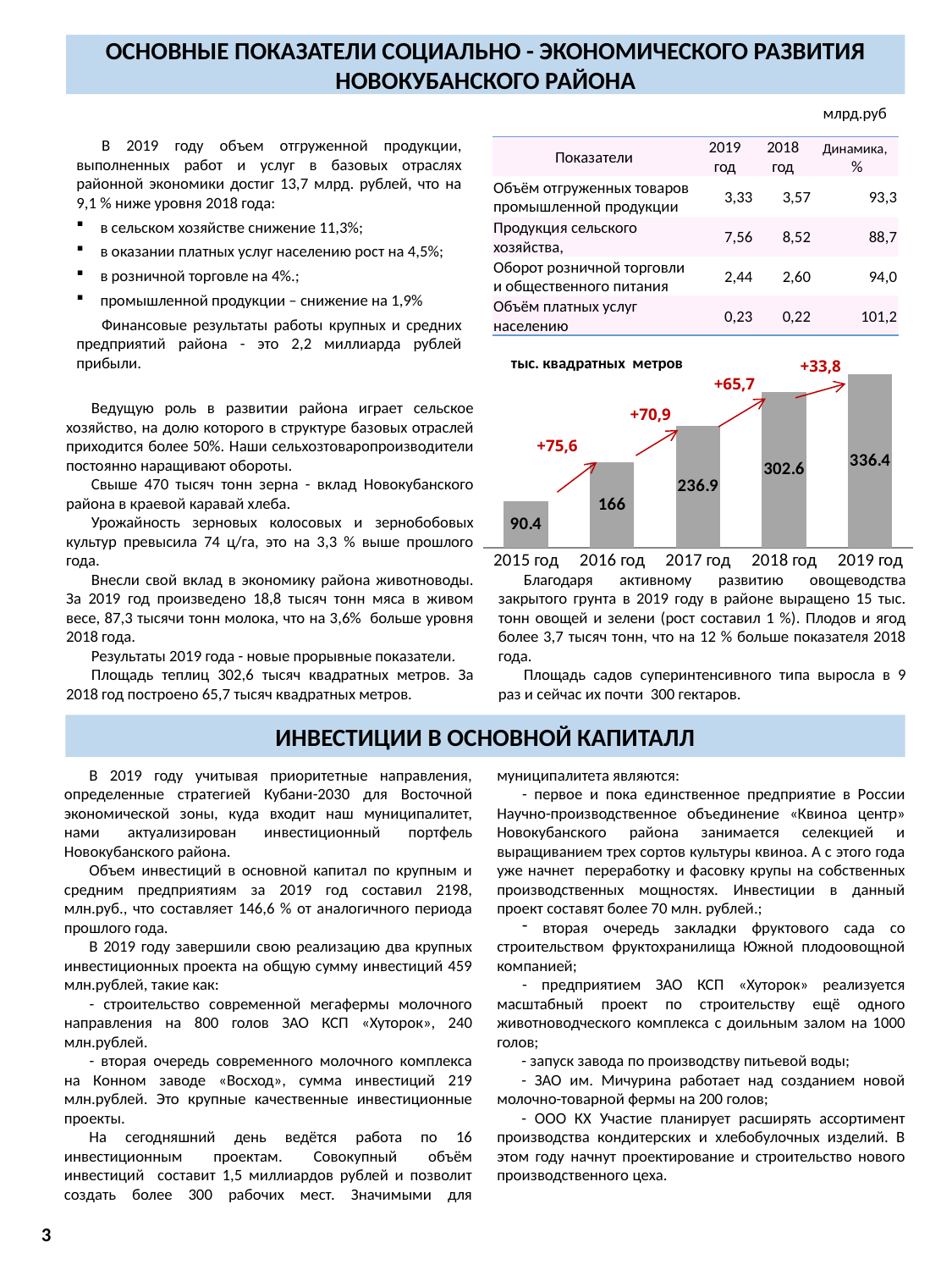
What is the value for 2015 год in the bar chart? 90.4 What is the difference between the values for 2017 год and 2016 год in the bar chart? 70.9 How many years are shown in the bar chart? 5 What is the value for 2019 год in the bar chart? 336.4 Which is larger in the bar chart, the value for 2017 год or 2018 год? 2018 год Do the values in the bar chart rise or fall from 2015 год to 2019 год? rise Which year has the highest value in the bar chart? 2019 год What is the value for 2016 год in the bar chart? 166 What is the value for 2018 год in the bar chart? 302.6 Which year has the lowest value in the bar chart? 2015 год What kind of chart is shown on the slide? bar chart What is the difference between the values for 2019 год and 2018 год in the bar chart? 33.8